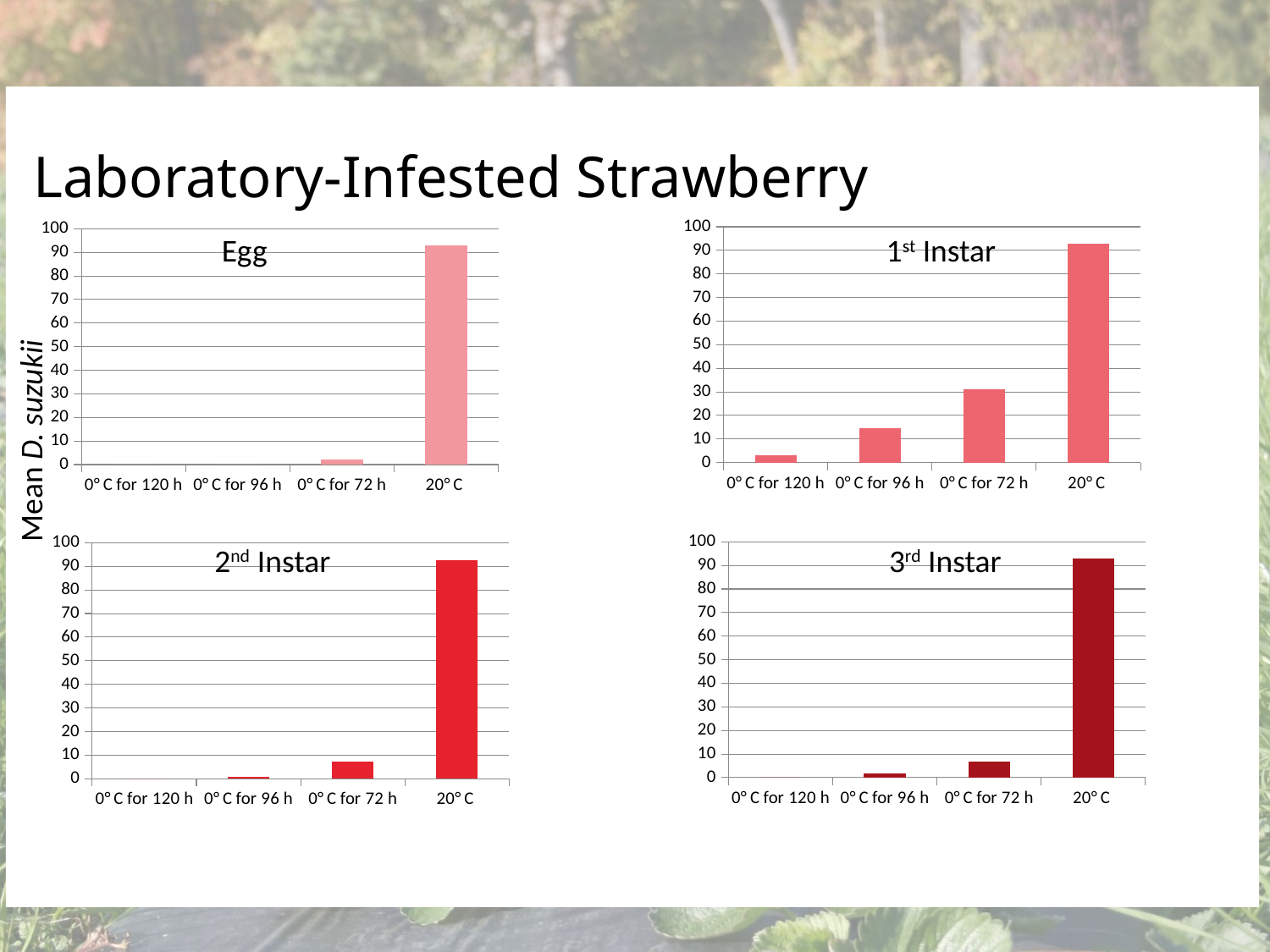
In the 1st Instar chart, do the values rise or fall from left to right along the x axis? rise What is the label on the shared y axis of the charts? Mean D. suzukii In the 3rd Instar chart, which category has the lowest value? 0° C for 120 h In the 2nd Instar chart, is the value for 0° C for 72 h greater or less than 10? less In the Egg chart, is the value for 20° C greater or less than 80? greater How many charts are shown on the slide? 4 In the 3rd Instar chart, which category has the highest value? 20° C In the 1st Instar chart, which is larger, the value for 0° C for 96 h or the value for 0° C for 72 h? 0° C for 72 h In the Egg chart, which category has the highest value? 20° C In the 1st Instar chart, is the value for 0° C for 72 h greater or less than 20? greater In the 1st Instar chart, how many categories are on the x axis? 4 What kind of chart is the Egg chart? bar chart